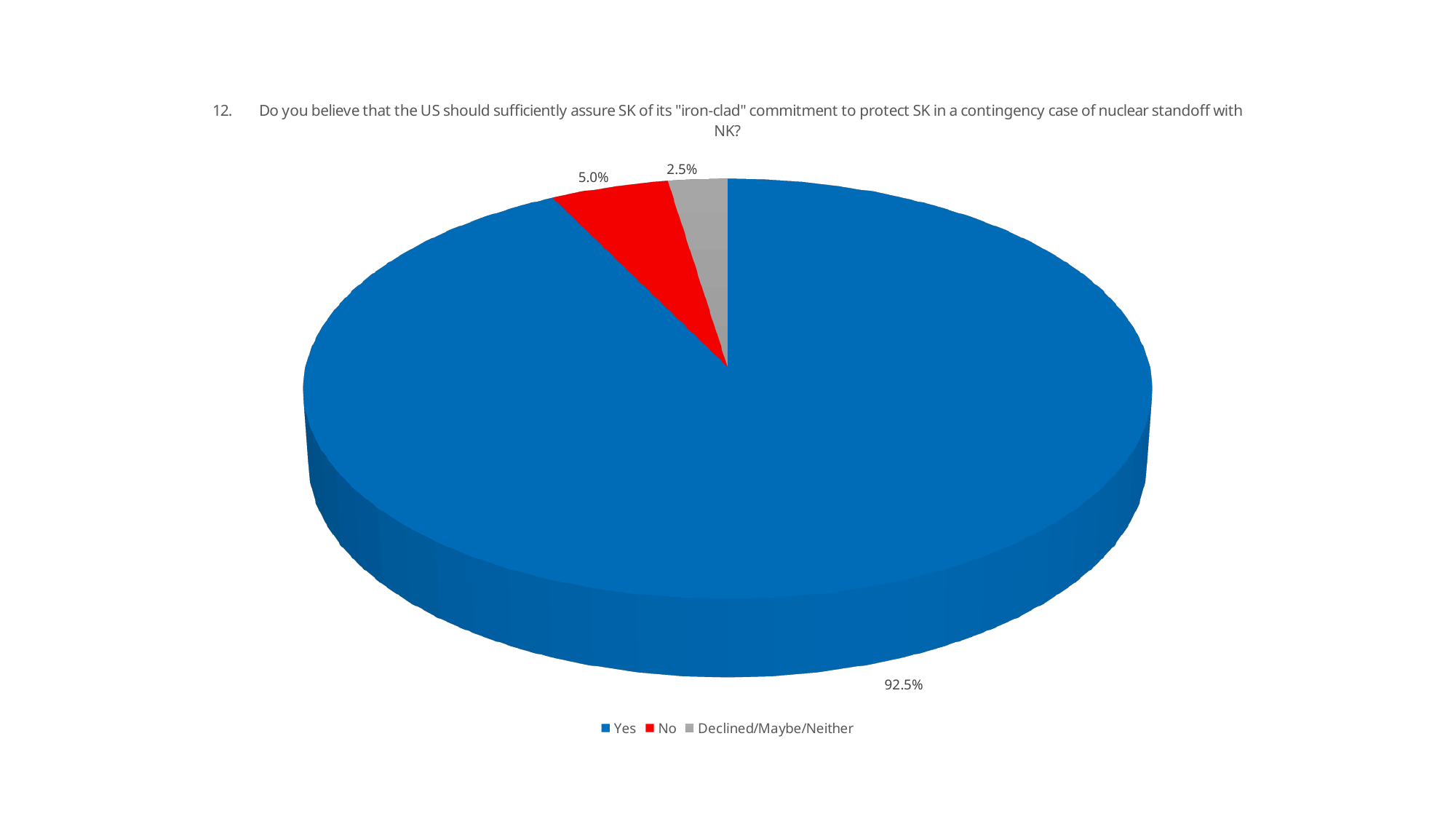
What percentage of respondents answered Yes? 92.5% Which is larger, the share for No or the share for Declined/Maybe/Neither? No What colour is the slice representing No? Red What kind of chart is shown on the slide? Pie chart What percentage of respondents answered Declined/Maybe/Neither? 2.5% Which response has the smallest share of the pie? Declined/Maybe/Neither Which response has the largest share of the pie? Yes What is the difference in percentage points between the No and Declined/Maybe/Neither shares? 2.5 What is the difference in percentage points between the Yes and No shares? 87.5 What percentage of respondents answered No? 5.0% How many slices does the pie chart have? 3 How many entries does the legend list? 3